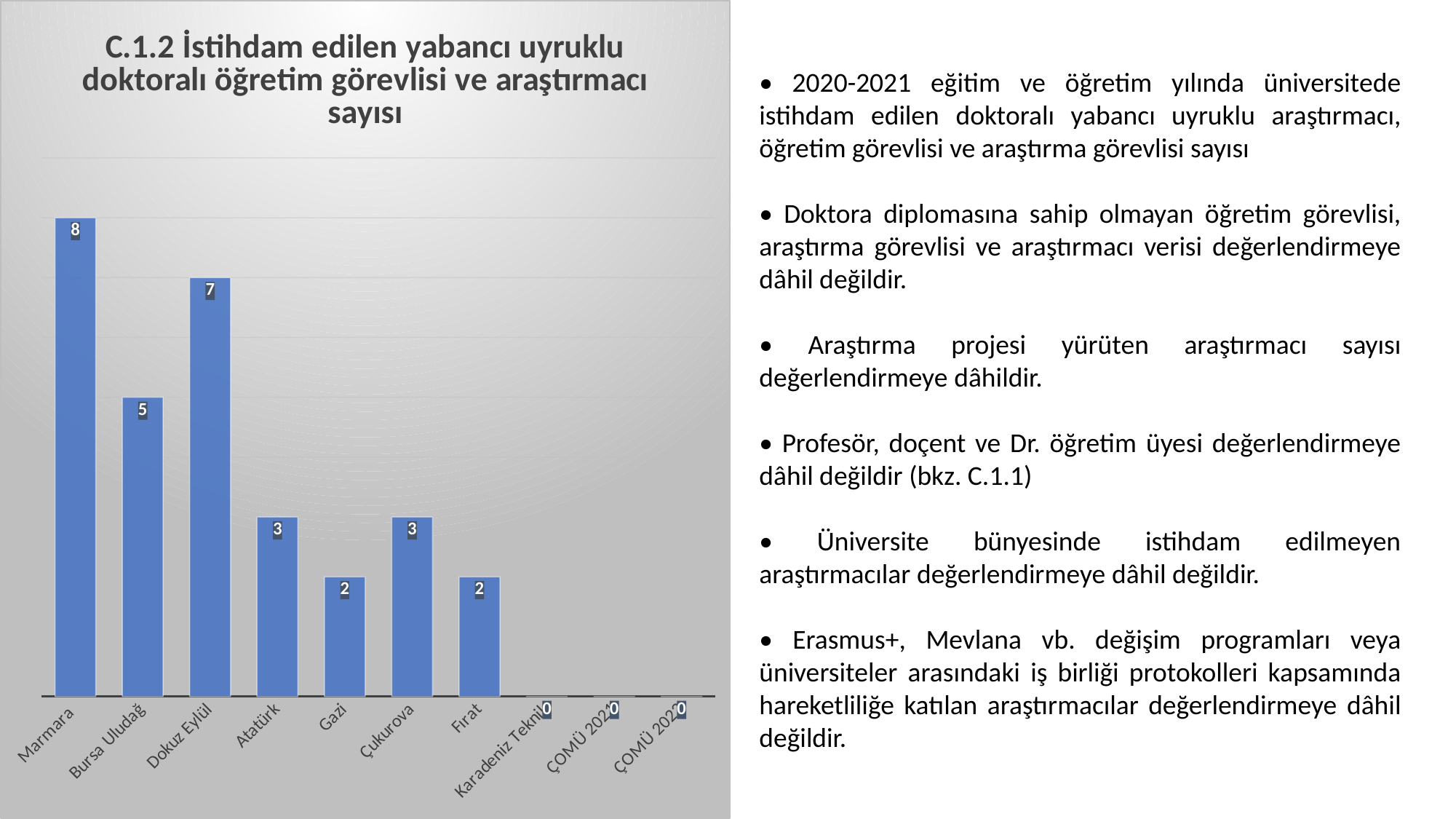
Which is larger, the value for Bursa Uludağ or the value for Fırat? Bursa Uludağ How many categories are shown on the x axis? 10 Which is larger, the value for Gazi or the value for Çukurova? Çukurova What is the title of the chart? C.1.2 İstihdam edilen yabancı uyruklu doktoralı öğretim görevlisi ve araştırmacı sayısı What is the value for Karadeniz Teknik? 0 What is the value for Bursa Uludağ? 5 Which university has the highest value? Marmara What type of chart is shown on the slide? bar chart What is the difference between the values for Marmara and Bursa Uludağ? 3 What is the value for Dokuz Eylül? 7 What is the value for Marmara? 8 What is the difference between the values for Dokuz Eylül and Atatürk? 4